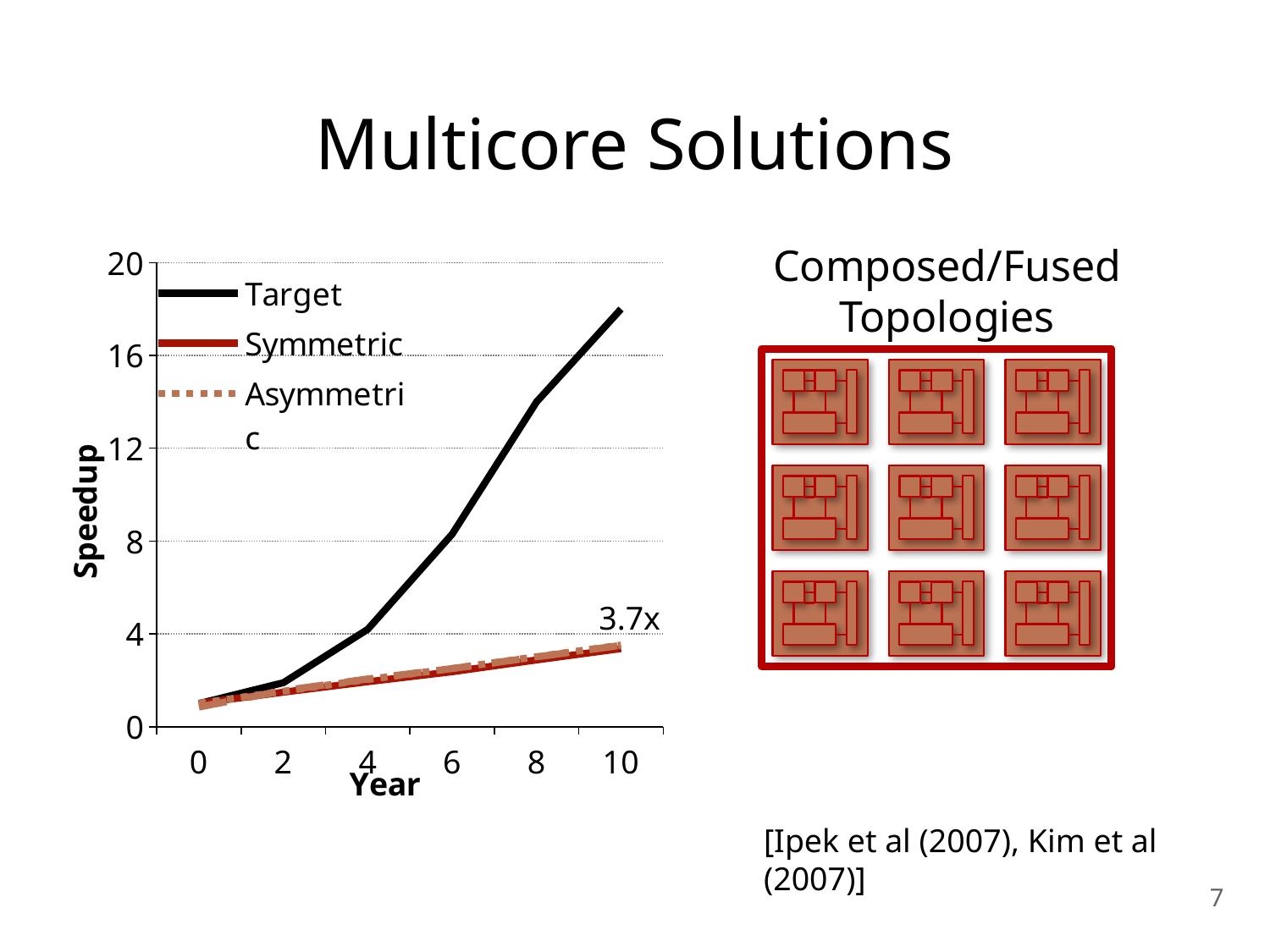
Which series has the highest speedup at year 10? Target What is the label of the chart's vertical axis? Speedup What annotation is printed next to the end of the Symmetric and Asymmetric lines? 3.7x At year 10, which series has the higher speedup, Target or Symmetric? Target What kind of chart is shown on the slide? Line chart How many series does the chart's legend list? 3 Is the Target speedup at year 10 greater or less than 16? greater Is the Target speedup at year 4 greater or less than 8? less Does the Target series rise or fall as Year increases? Rises What is the highest value shown on the Speedup axis? 20 Is the Symmetric speedup at year 10 greater or less than 4? less What are the three series named in the chart's legend? Target, Symmetric, Asymmetric